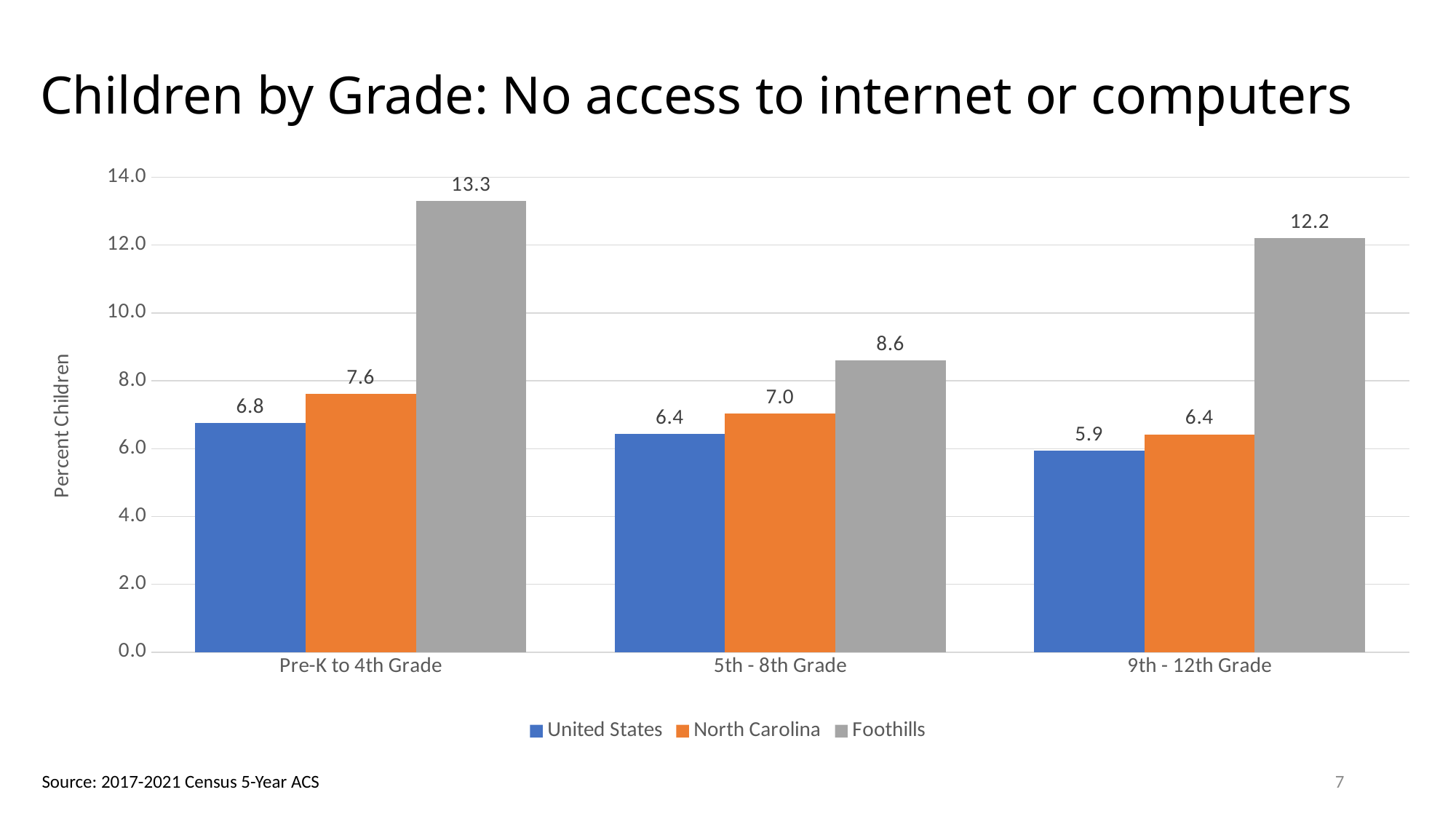
Do the United States values rise or fall from Pre-K to 4th Grade to 9th - 12th Grade? fall Which grade category has the lowest United States value? 9th - 12th Grade Which is larger for 5th - 8th Grade: the North Carolina value or the United States value? North Carolina Is the Foothills value for 5th - 8th Grade greater or less than 10.0? less What is the value for United States in the 9th - 12th Grade category? 5.9 How many grade categories are shown on the x axis? 3 What kind of chart is shown on the slide? bar chart What is the value for Foothills in the Pre-K to 4th Grade category? 13.3 How many series does the legend list? 3 Which grade category has the highest Foothills value? Pre-K to 4th Grade What is the difference between the Foothills and United States values for 9th - 12th Grade? 6.3 What is the value for North Carolina in the 5th - 8th Grade category? 7.0